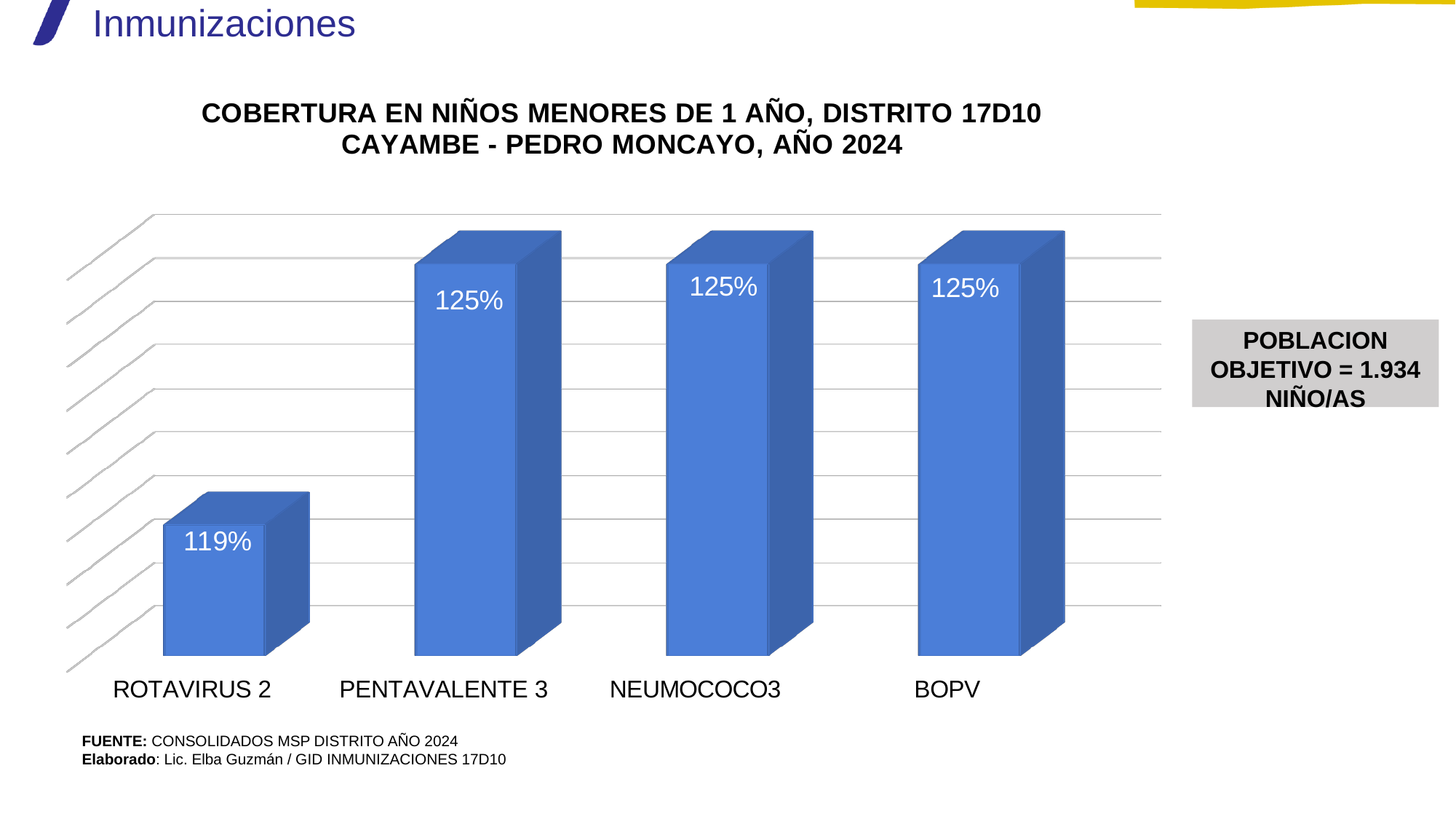
What is the difference between the coverage for PENTAVALENTE 3 and ROTAVIRUS 2? 6% What is the target population (POBLACION OBJETIVO) stated next to the chart? 1.934 NIÑO/AS What kind of chart is shown on the slide? Bar chart What is the coverage value for BOPV? 125% What year does the chart title refer to? 2024 What is the coverage value for PENTAVALENTE 3? 125% How many vaccines are shown on the chart? 4 What is the coverage value for ROTAVIRUS 2? 119% Which is larger, the coverage for BOPV or for ROTAVIRUS 2? BOPV How many vaccines have a coverage of 125%? 3 What is the coverage value for NEUMOCOCO3? 125% Which vaccine has the lowest coverage? ROTAVIRUS 2